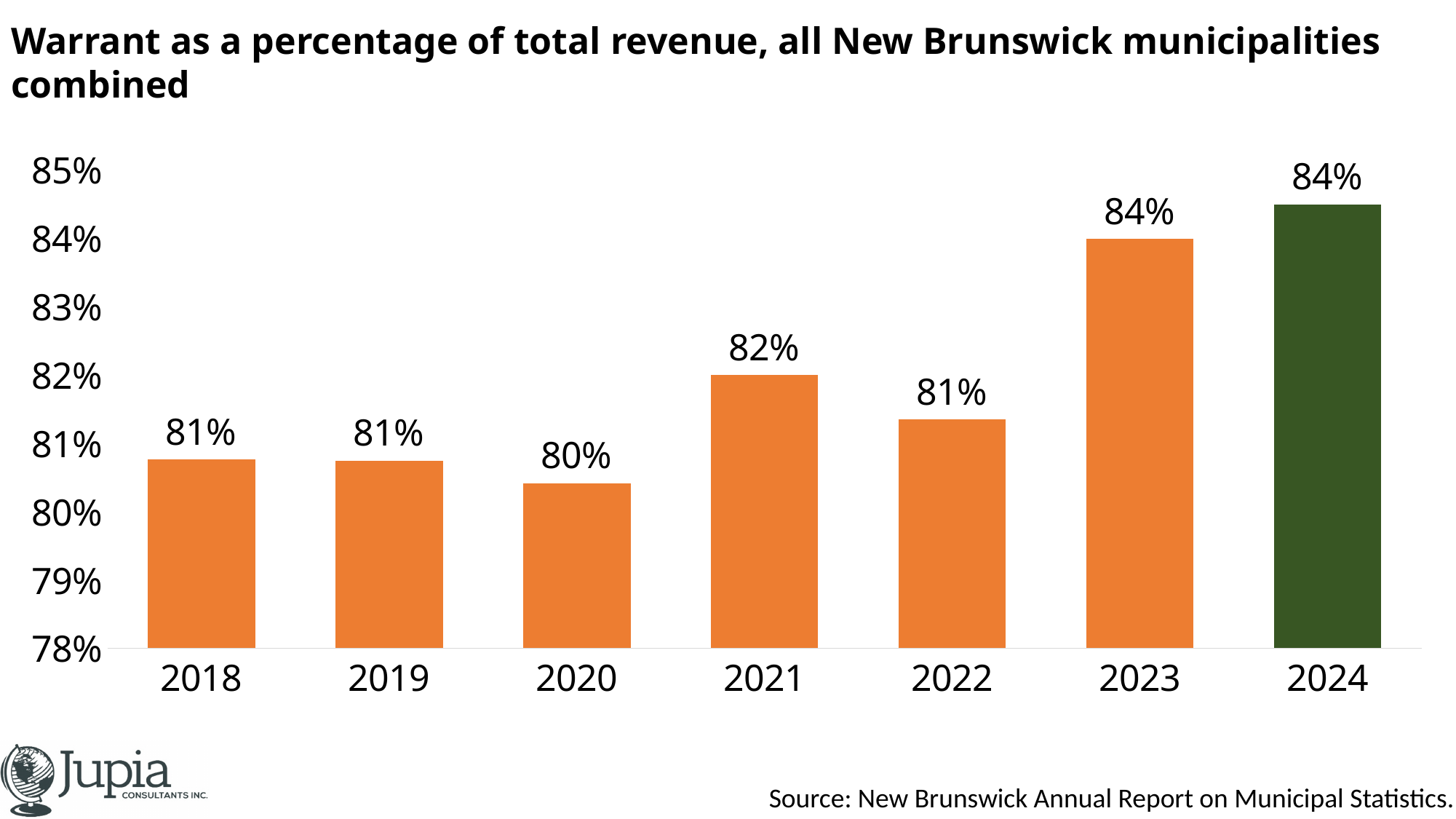
What is the warrant as a percentage of total revenue for 2021? 82% Which year's bar is coloured green rather than orange? 2024 What kind of chart is shown on the slide? Bar chart Is the value for 2021 greater or less than 81%? greater What is the warrant as a percentage of total revenue for 2024? 84% What is the difference between the 2023 value and the 2020 value? 4% Do the values generally rise or fall from 2018 to 2024? Rise Which year has the larger value, 2021 or 2022? 2021 What is the warrant as a percentage of total revenue for 2018? 81% Which year has the lowest warrant as a percentage of total revenue? 2020 How many years are shown on the chart? 7 What is the warrant as a percentage of total revenue for 2020? 80%